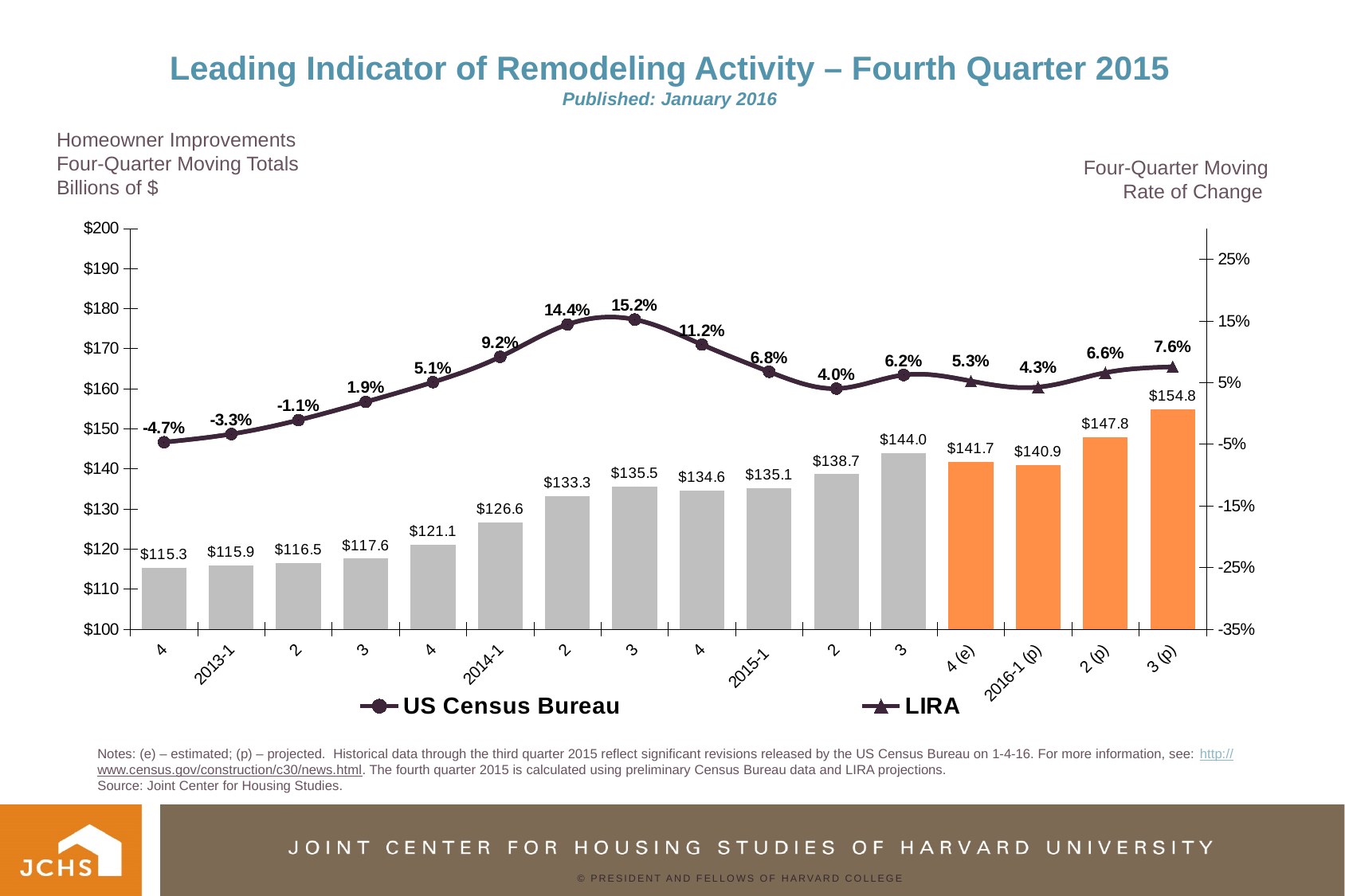
How many bars are plotted in the chart? 16 What is the four-quarter moving total for 2015-1? $135.1 What is the difference between the four-quarter moving totals for 3 (2015) and 4 (e)? $2.3 Which period has the highest four-quarter moving rate of change? 3 (2014), 15.2% Which is larger, the four-quarter moving total for 2 (2014) or for 4 (2014)? 4 (2014), $134.6 Which period has the lowest four-quarter moving total bar? 4 (2012), $115.3 What is the projected four-quarter moving total for 3 (p) of 2016? $154.8 What kind of chart is this? Combination bar and line chart What is the four-quarter moving rate of change shown for 2014-1? 9.2% What are the two series named in the legend? US Census Bureau and LIRA Do the four-quarter moving totals rise or fall from 4 (2012) through 3 (2015)? Rise How many series does the legend list? 2